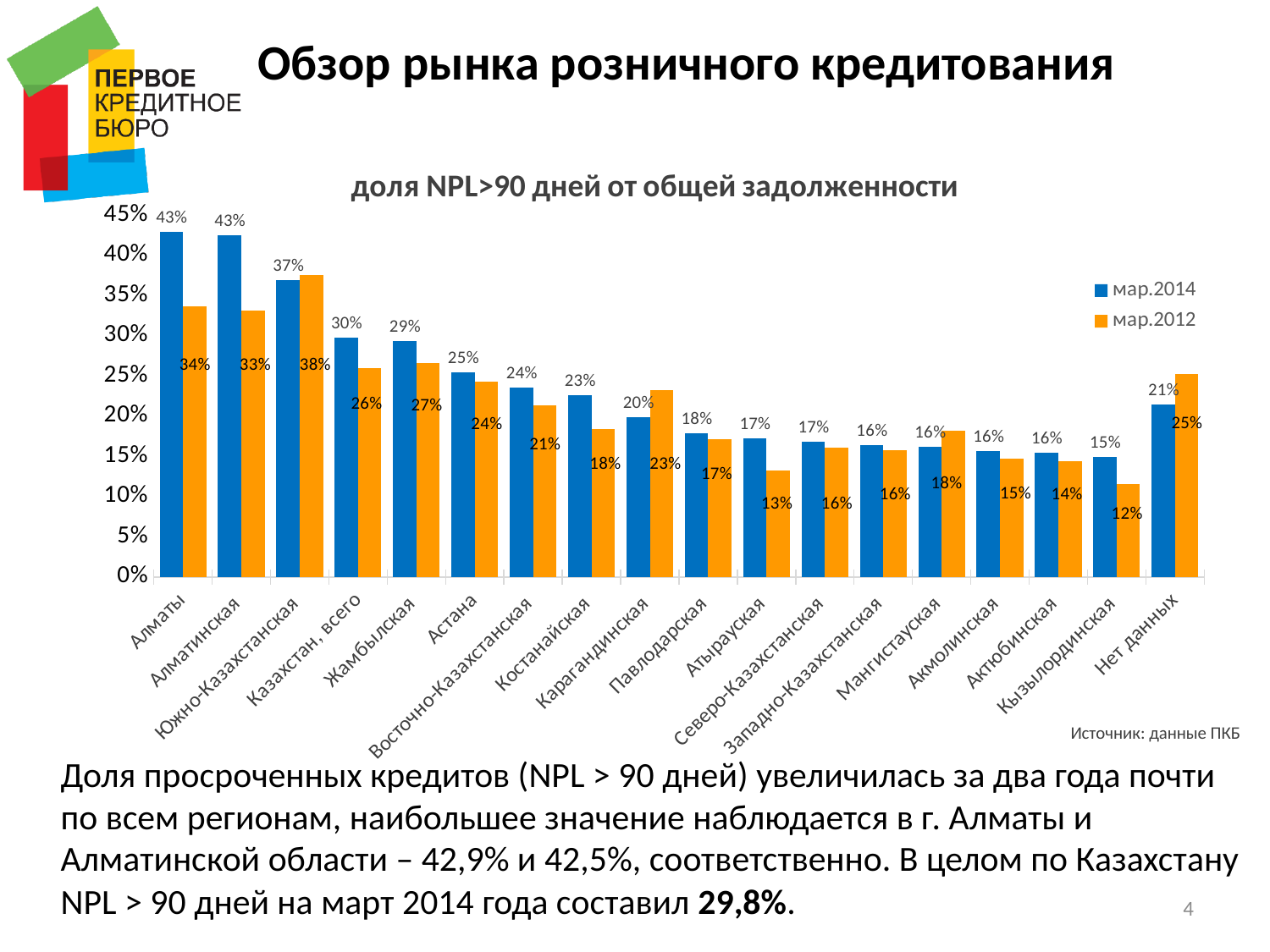
What kind of chart is shown on the slide? Bar chart For Южно-Казахстанская, which is larger: the мар.2014 value or the мар.2012 value? мар.2012 Which category has the lowest мар.2012 value? Кызылординская How many series does the legend list? 2 How many categories are shown on the x axis? 18 What is the мар.2014 value for Казахстан, всего? 30% What is the title of the chart? доля NPL>90 дней от общей задолженности What is the мар.2012 value for Атырауская? 13% What is the мар.2014 value for Алматы? 43% Which category has the highest мар.2012 value? Южно-Казахстанская What is the difference between the мар.2014 and мар.2012 values for Алматы? 9 percentage points What is the мар.2012 value for Южно-Казахстанская? 38%